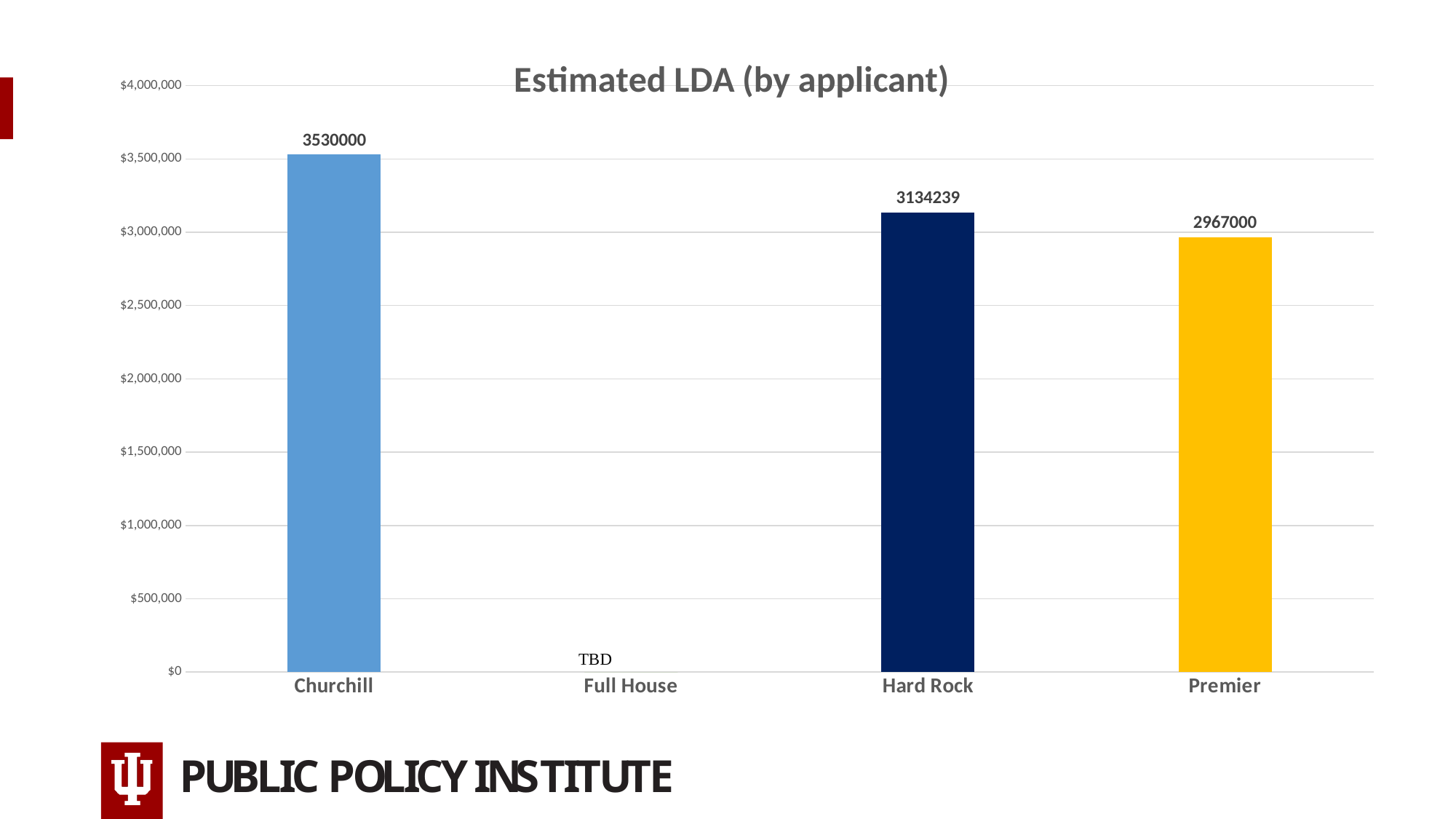
Which is larger, the estimated LDA for Hard Rock or for Premier? Hard Rock What is shown for Full House instead of a bar value? TBD What is the estimated LDA value shown for Premier? 2967000 Is the value for Premier greater or less than $3,000,000? less What is the estimated LDA value shown for Hard Rock? 3134239 What kind of chart is shown on the slide? Bar chart Which applicant has the highest estimated LDA? Churchill What is the difference between the estimated LDA for Churchill and Hard Rock? 395761 What is the estimated LDA value shown for Churchill? 3530000 Among the applicants with a plotted bar, which has the lowest estimated LDA? Premier What is the difference between the estimated LDA for Hard Rock and Premier? 167239 How many applicants are listed on the x axis? 4